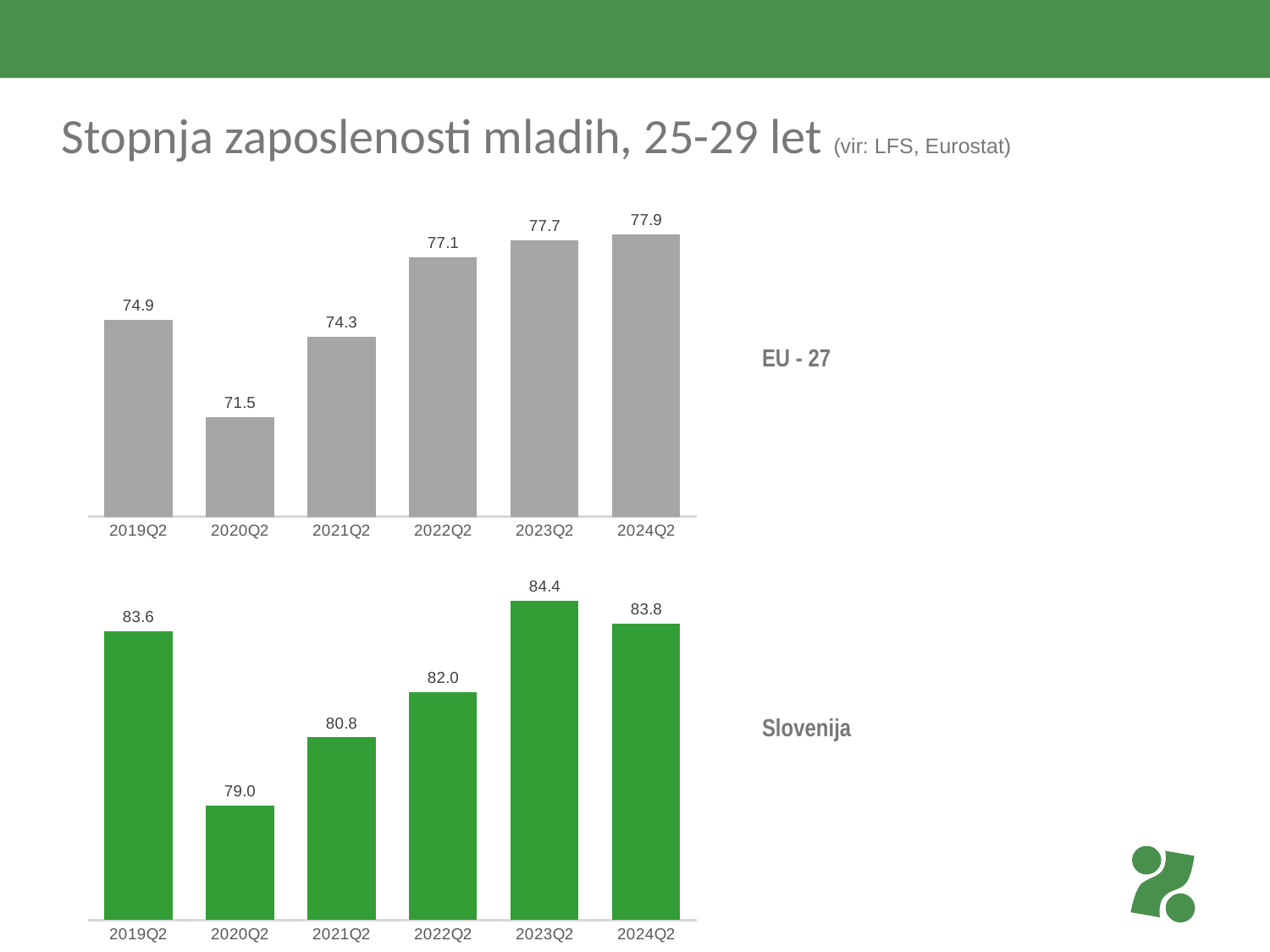
In the EU - 27 chart, which period has the highest value? 2024Q2 In the EU - 27 chart, which is larger, the value for 2019Q2 or the value for 2021Q2? 2019Q2 In the EU - 27 chart, do the values rise or fall from 2020Q2 to 2024Q2? rise In the Slovenija chart, what is the value for 2022Q2? 82.0 How many periods are shown on the x axis of the EU - 27 chart? 6 In the Slovenija chart, which period has the lowest value? 2020Q2 In the Slovenija chart, which is larger, the value for 2019Q2 or the value for 2024Q2? 2024Q2 In the EU - 27 chart, what is the difference between the values for 2024Q2 and 2019Q2? 3.0 In the Slovenija chart, which period has the highest value? 2023Q2 What kind of chart is the Slovenija chart? bar chart In the EU - 27 chart, what is the value for 2020Q2? 71.5 In the Slovenija chart, what is the difference between the values for 2023Q2 and 2020Q2? 5.4